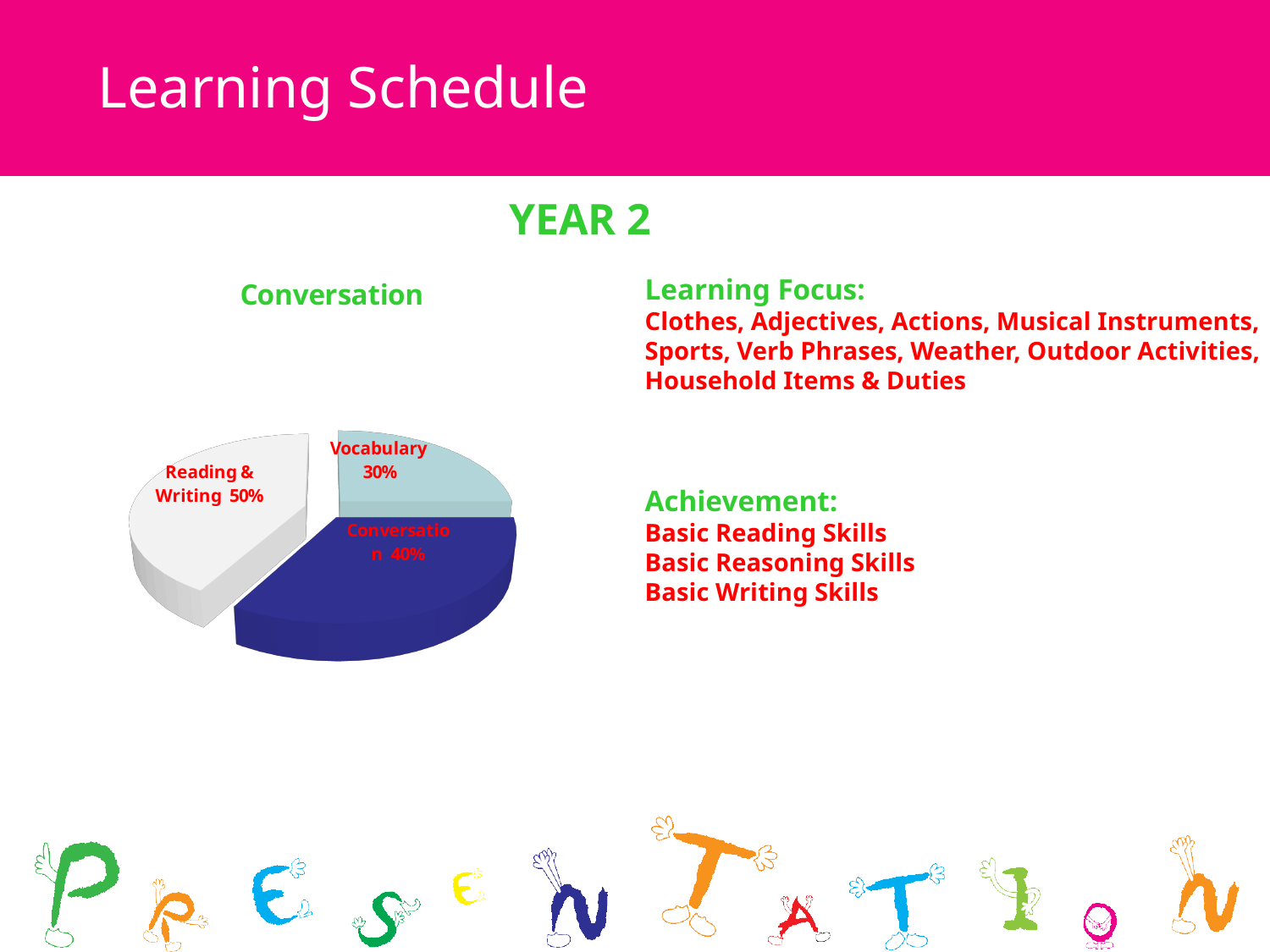
What is the difference between the Conversation percentage and the Vocabulary percentage? 10% What percentage is shown for the Conversation slice? 40% What is the title of the chart? Conversation How many slices does the pie chart have? 3 What is the difference between the Reading & Writing percentage and the Vocabulary percentage? 20% What percentage is shown for the Vocabulary slice? 30% Which slice of the pie chart is the smallest? Vocabulary Which slice of the pie chart is coloured dark blue? Conversation Which is larger, the Conversation slice or the Vocabulary slice? Conversation What type of chart is shown on the slide? pie chart Which slice of the pie chart is the largest? Reading & Writing What percentage is shown for the Reading & Writing slice? 50%